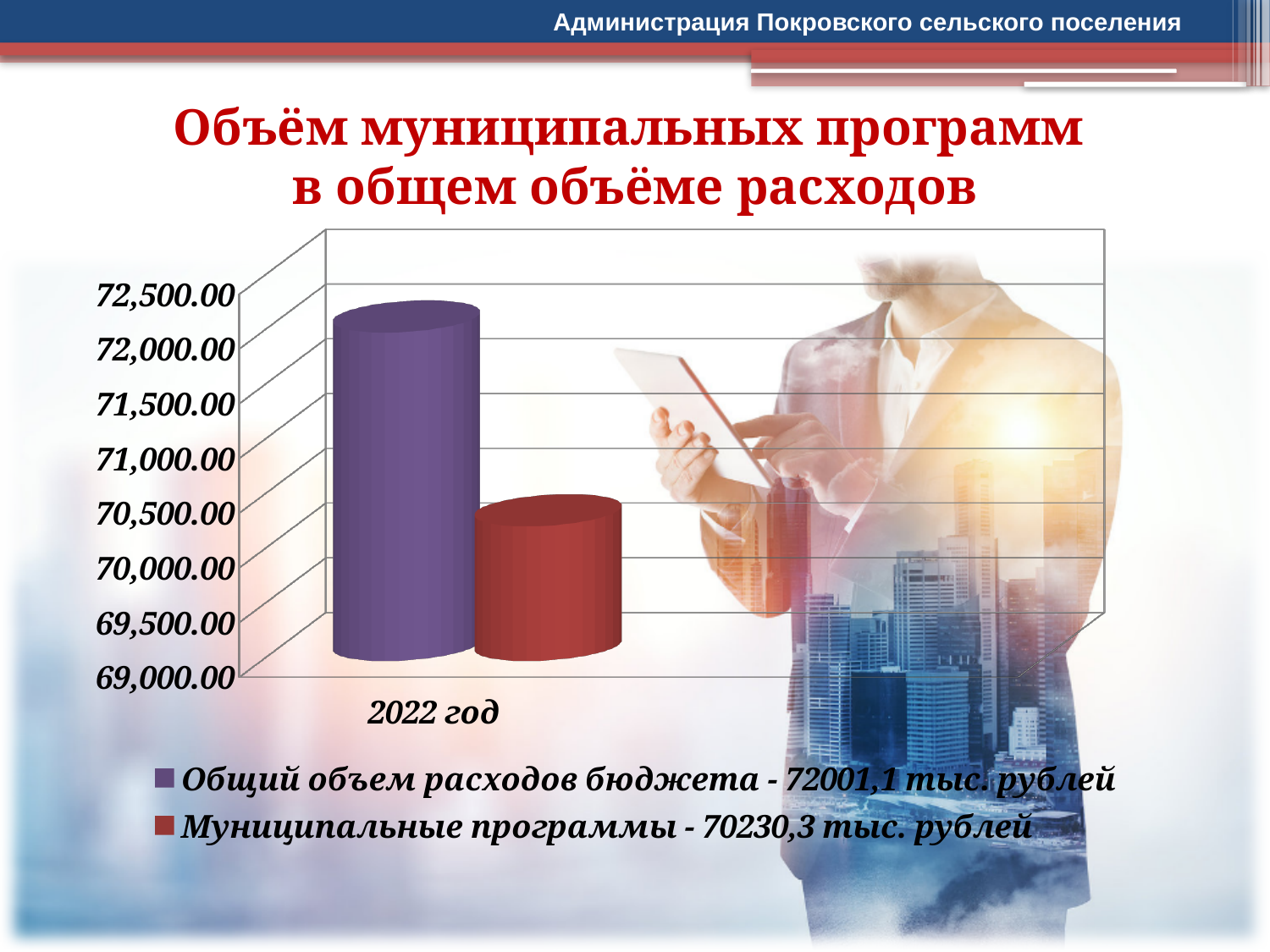
What value does the legend give for 'Муниципальные программы'? 70230,3 тыс. рублей Which series has the lowest value? Муниципальные программы Is the value for 'Муниципальные программы' greater or less than 70,500.00? less Which series has the higher value, 'Общий объем расходов бюджета' or 'Муниципальные программы'? Общий объем расходов бюджета What kind of chart is shown on the slide? bar chart What colour is the bar for 'Муниципальные программы'? red What category label is shown on the x axis? 2022 год What value does the legend give for 'Общий объем расходов бюджета'? 72001,1 тыс. рублей What is the difference between 'Общий объем расходов бюджета' and 'Муниципальные программы'? 1770,8 тыс. рублей How many categories are shown on the x axis? 1 How many series does the legend list? 2